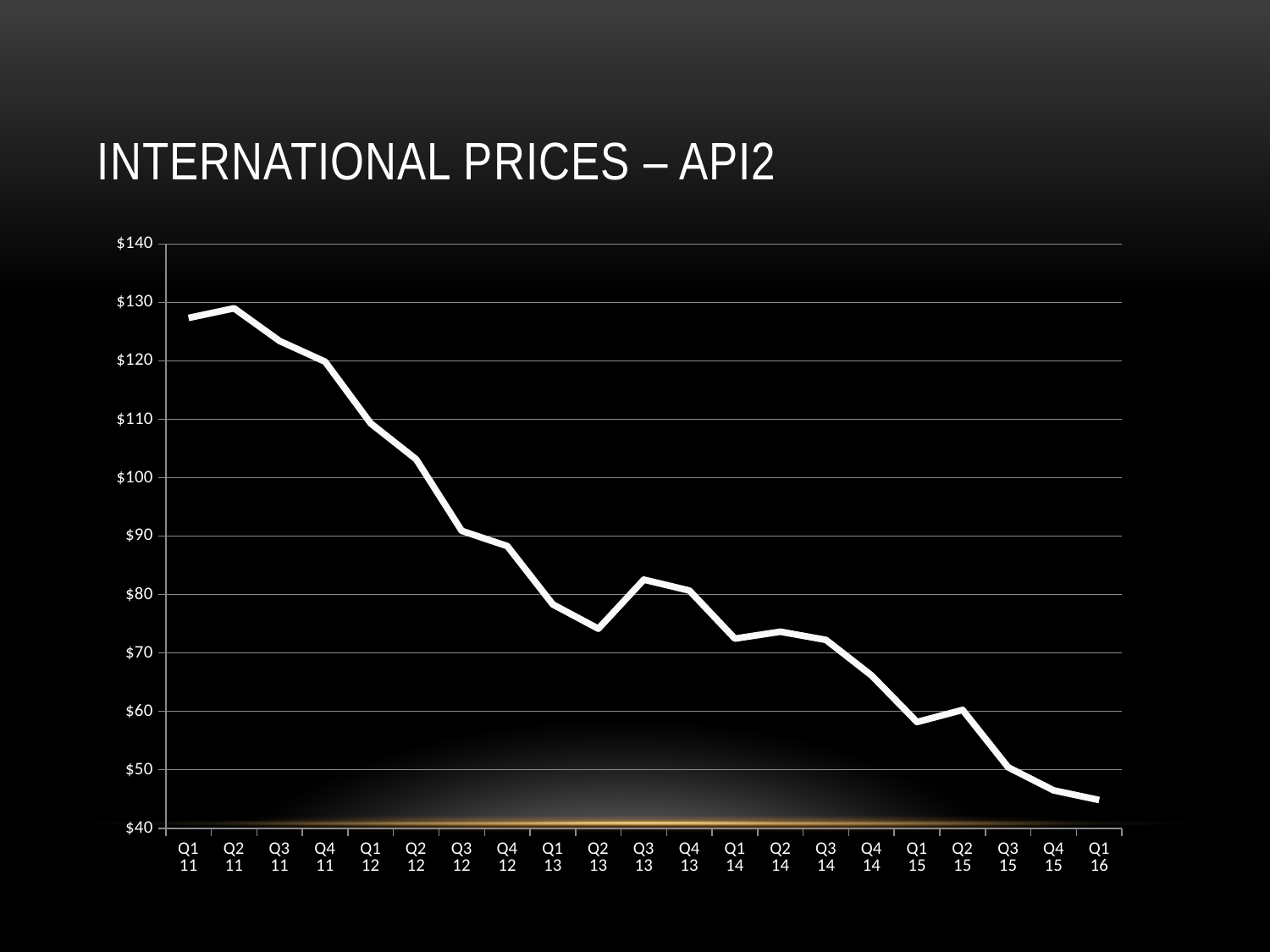
Is the value for Q1 11 greater or less than $120? greater Is the value for Q3 13 greater or less than $80? greater Is the value for Q4 14 greater or less than $70? less What is the title of the chart? International Prices – API2 What kind of chart is shown on the slide? line chart Which is larger, the value for Q1 11 or the value for Q1 16? Q1 11 Which is larger, the value for Q4 12 or the value for Q1 13? Q4 12 Do the values generally rise or fall from Q1 11 to Q1 16? fall How many quarterly data points are plotted on the chart? 21